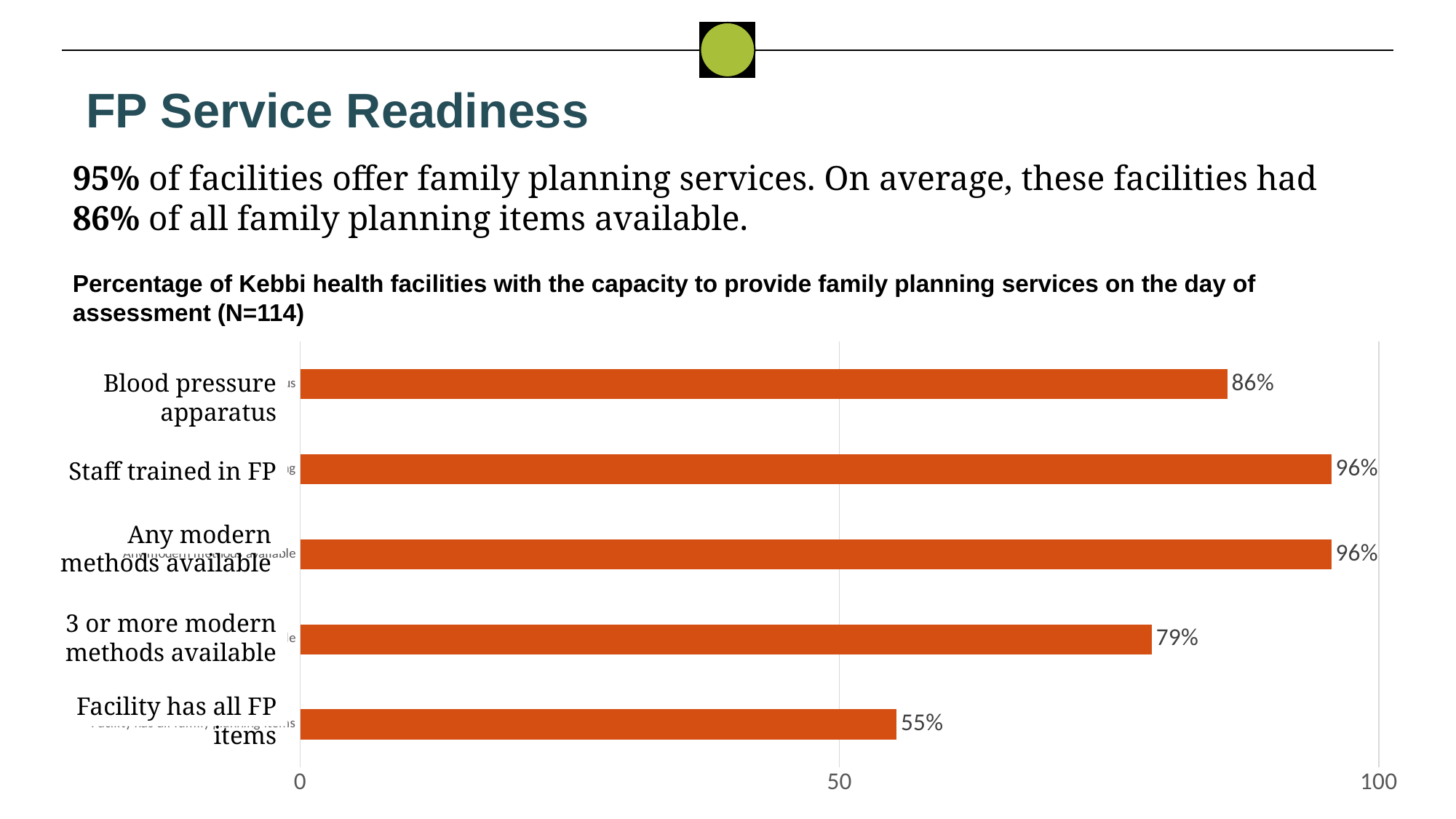
What is the sample size (N) stated in the chart title? 114 Which is larger: the percentage for 'Staff trained in FP' or 'Blood pressure apparatus'? Staff trained in FP How many categories are shown in the chart? 5 What percentage of facilities have 3 or more modern methods available? 79% Which category has the lowest percentage? Facility has all FP items What type of chart is shown on the slide? Bar chart What percentage of facilities have all FP items? 55% What is the difference between the percentage for 'Blood pressure apparatus' and 'Facility has all FP items'? 31% What percentage of facilities have a blood pressure apparatus? 86% Is the value for 'Facility has all FP items' greater or less than 50? greater What is the difference between the percentage for 'Any modern methods available' and '3 or more modern methods available'? 17% What percentage of facilities have staff trained in FP? 96%